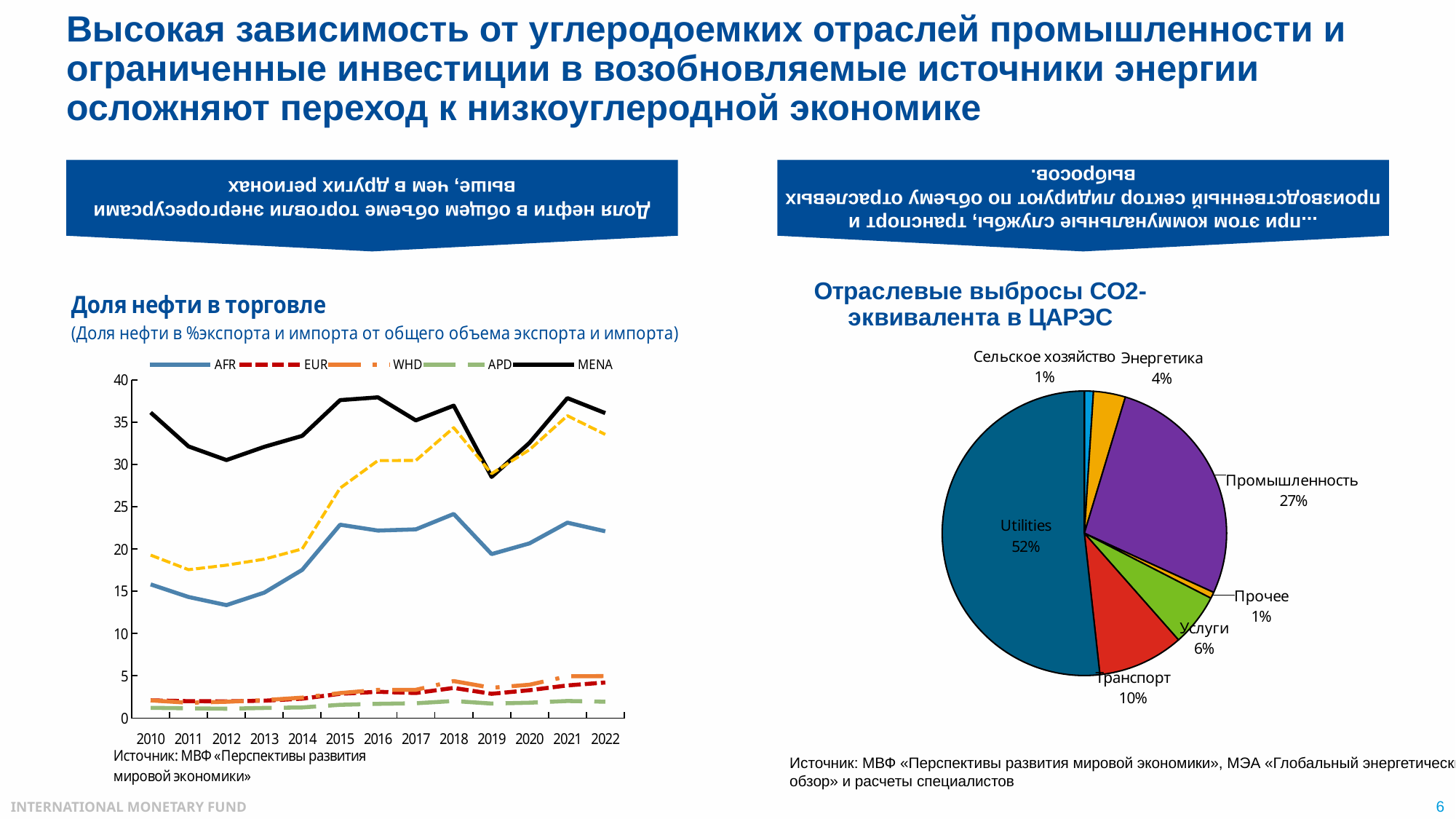
In the pie chart 'Отраслевые выбросы CO2-эквивалента в ЦАРЭС', what share does Промышленность have? 27% In the chart 'Доля нефти в торговле', is the value for MENA in 2010 greater or less than 35? greater In the pie chart 'Отраслевые выбросы CO2-эквивалента в ЦАРЭС', what share does Транспорт have? 10% What kind of chart is 'Доля нефти в торговле'? line chart In the pie chart 'Отраслевые выбросы CO2-эквивалента в ЦАРЭС', what is the difference between the shares of Промышленность and Транспорт? 17% In the pie chart 'Отраслевые выбросы CO2-эквивалента в ЦАРЭС', which slice is the largest? Utilities In the pie chart 'Отраслевые выбросы CO2-эквивалента в ЦАРЭС', how many slices are there? 7 In the chart 'Доля нефти в торговле', which series has the highest value in 2016? MENA In the pie chart 'Отраслевые выбросы CO2-эквивалента в ЦАРЭС', which is larger: Услуги or Энергетика? Услуги In the pie chart 'Отраслевые выбросы CO2-эквивалента в ЦАРЭС', what share does Utilities have? 52% In the chart 'Доля нефти в торговле', is the value for AFR in 2012 greater or less than 15? less In the chart 'Доля нефти в торговле', how many years are shown on the x axis? 13